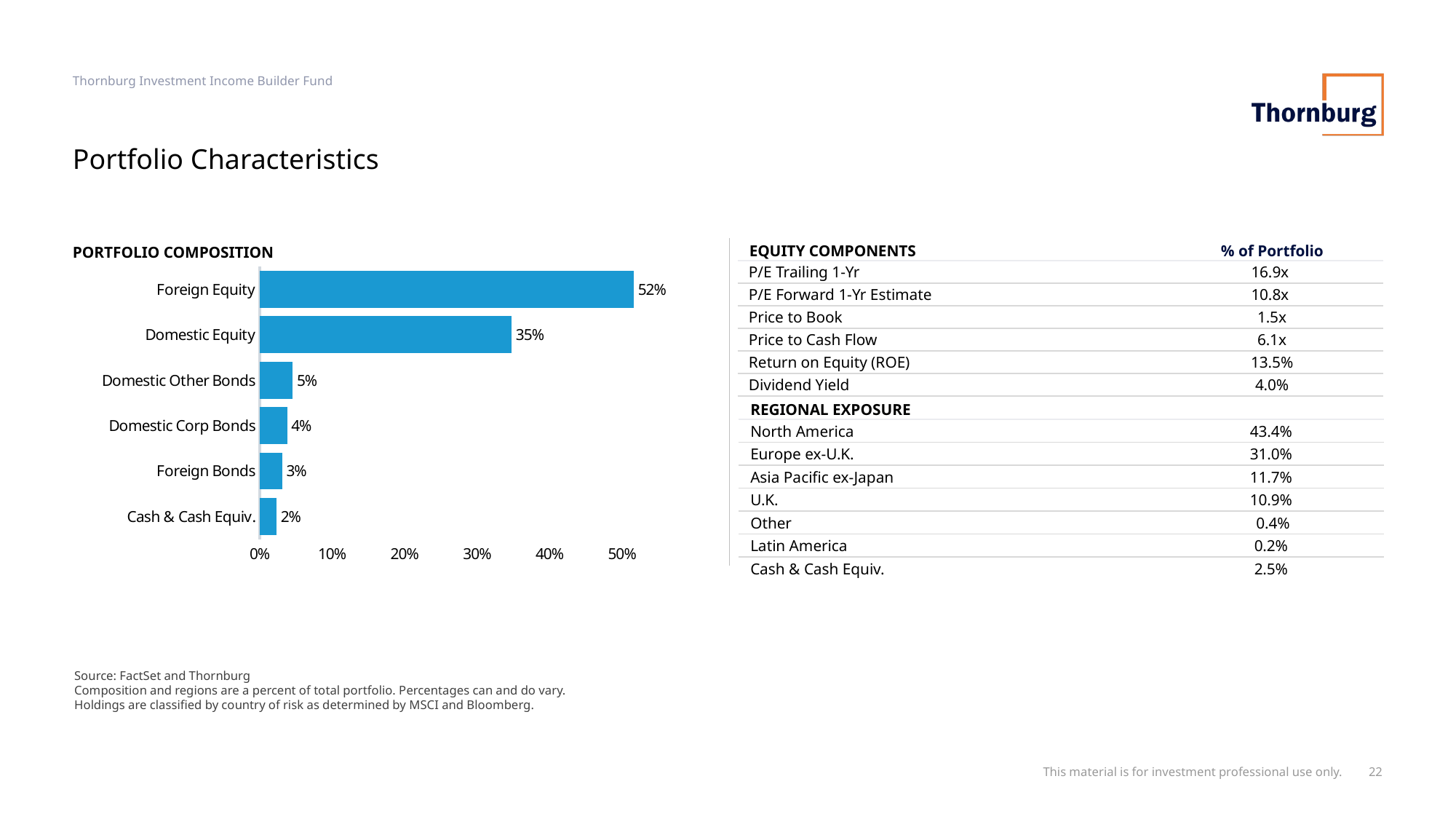
In the Portfolio Composition chart, which category has the lowest value? Cash & Cash Equiv. In the Portfolio Composition chart, which is larger, Domestic Corp Bonds or Foreign Bonds? Domestic Corp Bonds What kind of chart is the Portfolio Composition chart? Bar chart In the Portfolio Composition chart, what is the value for Domestic Equity? 35% In the Portfolio Composition chart, what is the value for Foreign Equity? 52% In the Portfolio Composition chart, what is the value for Domestic Other Bonds? 5% In the Portfolio Composition chart, what is the difference between Foreign Equity and Domestic Equity? 17% What is the title of the chart on the left of the slide? PORTFOLIO COMPOSITION How many categories are shown in the Portfolio Composition chart? 6 In the Portfolio Composition chart, what is the value for Cash & Cash Equiv.? 2% In the Portfolio Composition chart, is the value for Domestic Equity greater or less than 30%? greater In the Portfolio Composition chart, which category has the highest value? Foreign Equity